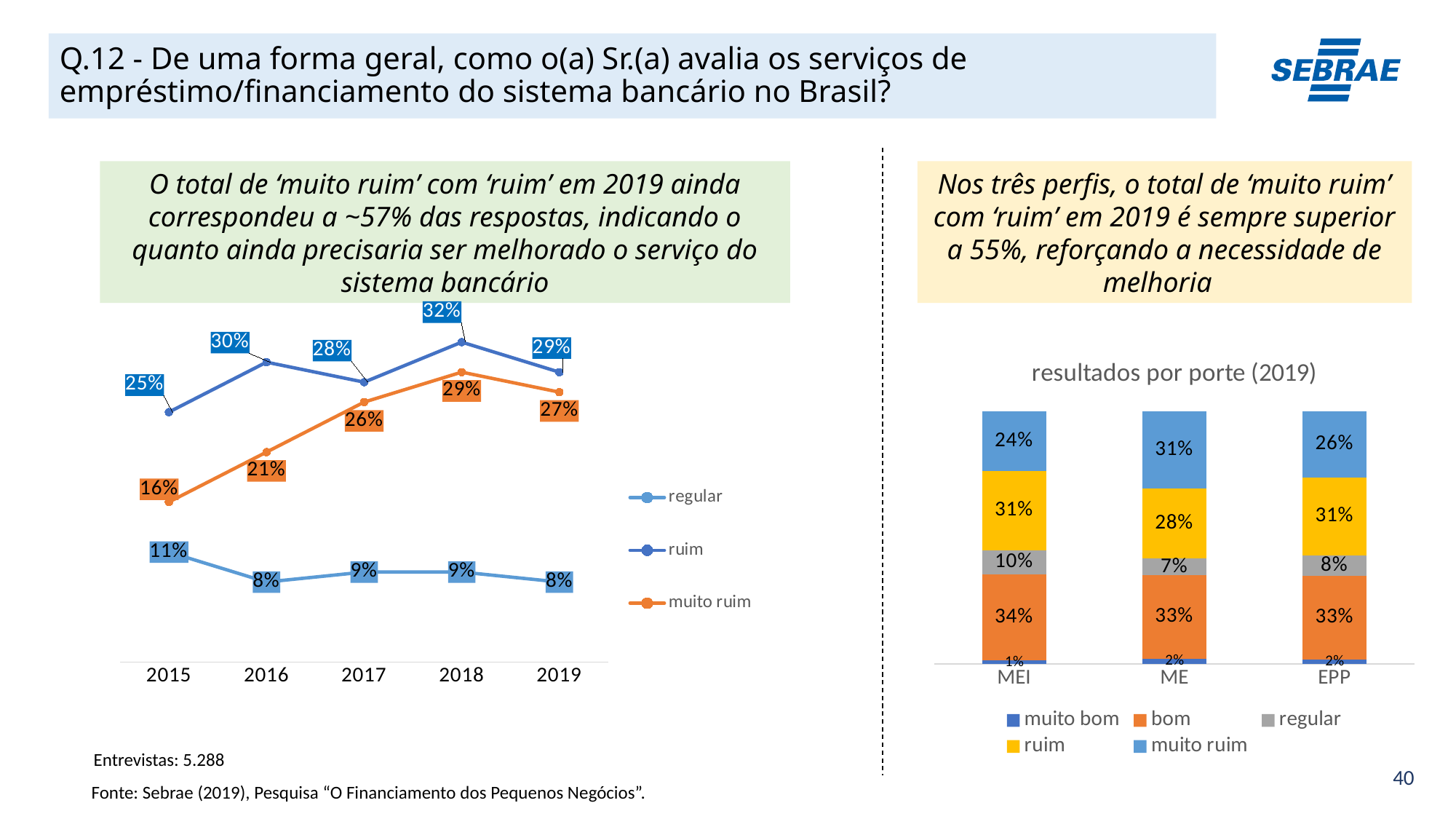
In the chart 'resultados por porte (2019)', which category has the highest value for 'muito ruim'? ME In the line chart on the left, what is the value for 'ruim' in 2018? 32% What type of chart is 'resultados por porte (2019)'? bar chart In the line chart on the left, does 'muito ruim' rise or fall from 2015 to 2018? rise How many series does the legend of the chart 'resultados por porte (2019)' list? 5 How many series does the legend of the line chart on the left list? 3 In the line chart on the left, in which year is 'muito ruim' highest? 2018 In the chart 'resultados por porte (2019)', which is larger: 'regular' for MEI or 'regular' for EPP? MEI In the line chart on the left, what is the difference between 'ruim' and 'muito ruim' in 2019? 2% In the line chart on the left, in which year is 'regular' highest? 2015 In the line chart on the left, what is the value for 'muito ruim' in 2015? 16% In the chart 'resultados por porte (2019)', what is the value for 'ruim' for ME? 28%